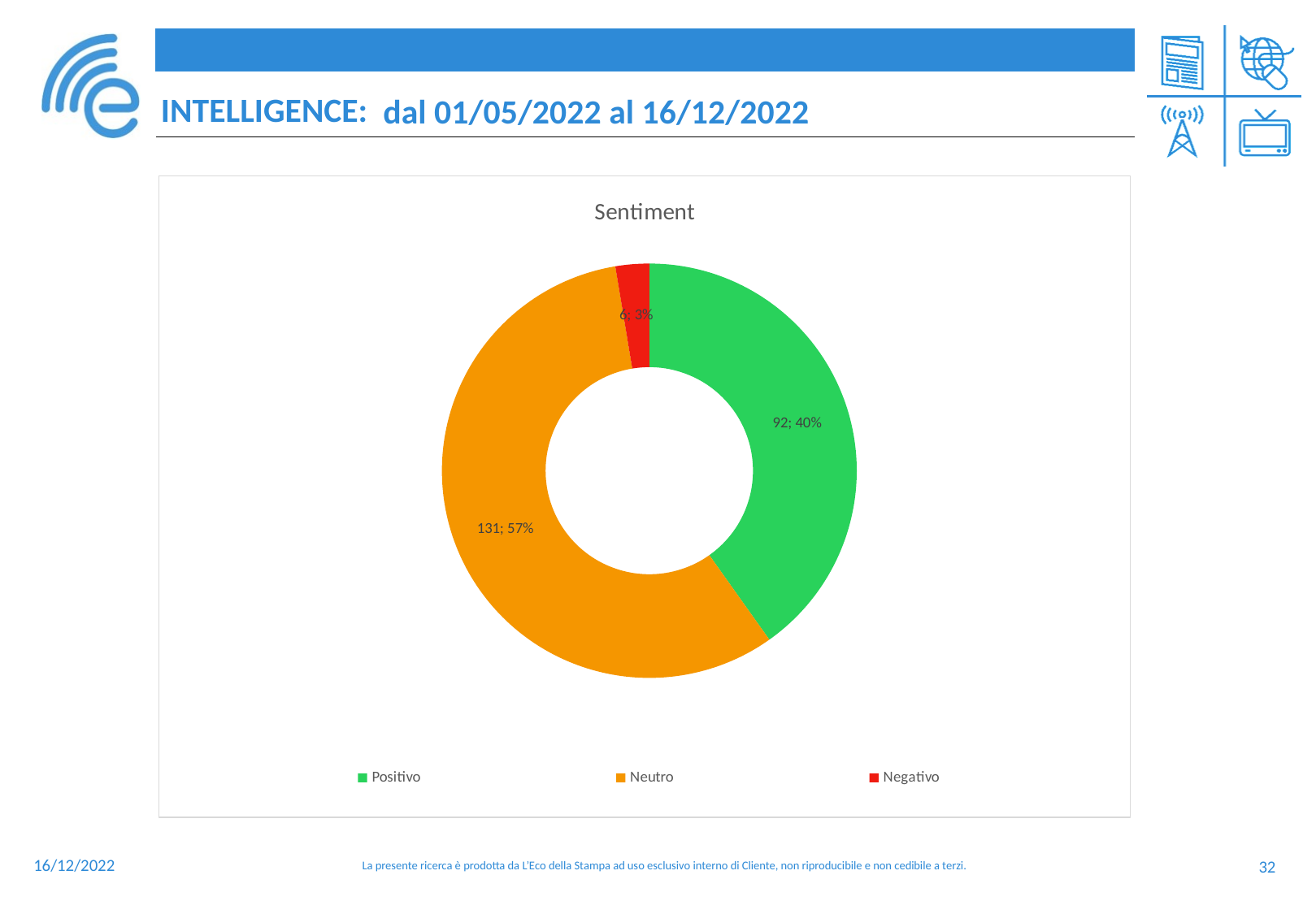
What is the title of the chart? Sentiment Which colour represents Negativo in the chart? red Which category has the lowest value? Negativo What is the value for Positivo? 92 What share of the chart does Positivo represent? 40% Which category has the highest value? Neutro What is the value for Negativo? 6 What share of the chart does Neutro represent? 57% What is the difference between the values for Neutro and Positivo? 39 How many categories does the Sentiment chart show? 3 What is the value for Neutro? 131 What kind of chart is shown on the slide? doughnut (pie) chart